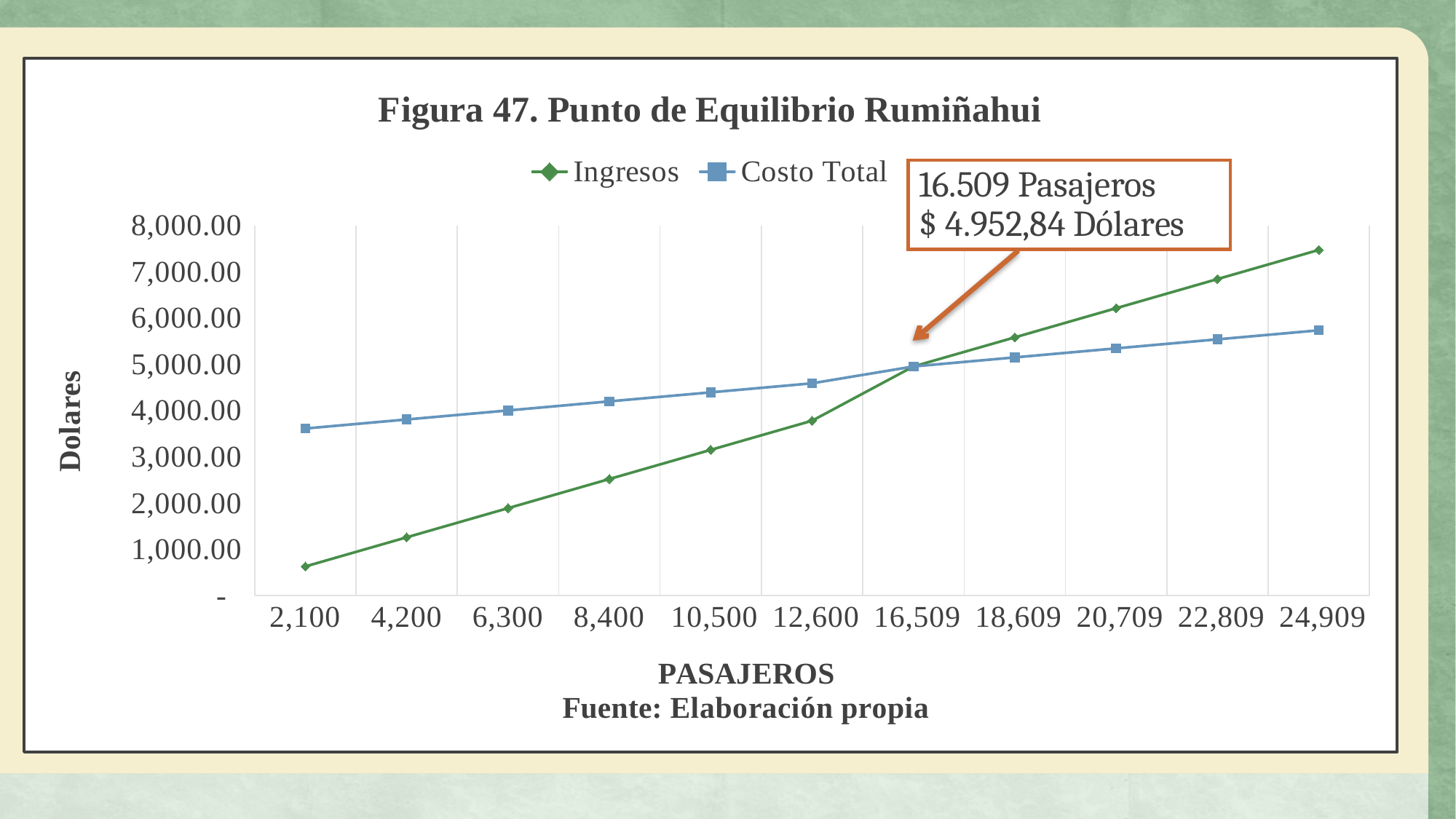
According to the annotation, what is the dollar value at the break-even point? $ 4.952,84 Dólares Is the Ingresos value at 24,909 passengers greater or less than 7,000.00? greater According to the annotation, at how many passengers is the break-even point (punto de equilibrio)? 16.509 Pasajeros What is the title of the chart? Figura 47. Punto de Equilibrio Rumiñahui How many series does the legend list? 2 Is the Ingresos value at 2,100 passengers greater or less than 1,000.00? less Is the Costo Total value at 2,100 passengers greater or less than 3,000.00? greater What kind of chart is shown on the slide? line chart At 24,909 passengers, which series has the larger value, Ingresos or Costo Total? Ingresos What label is shown on the vertical axis? Dolares How many passenger values are marked along the x axis? 11 Do the Ingresos values rise or fall as the number of passengers increases along the x axis? rise